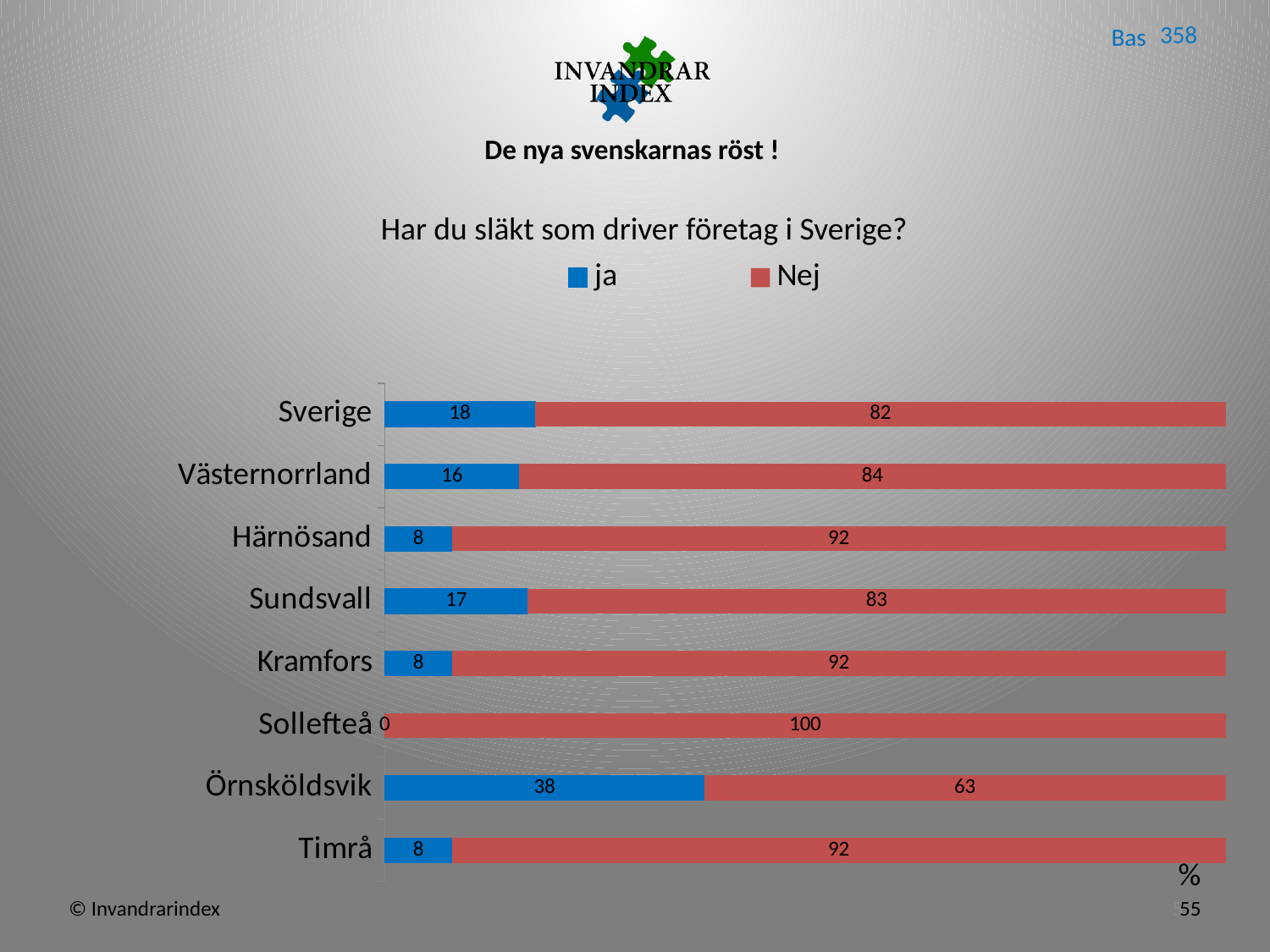
What is the 'Nej' value for Sollefteå? 100 What kind of chart is shown on the slide? Stacked bar chart What is the total of the stacked bar for Örnsköldsvik? 101 What is the 'ja' value for Örnsköldsvik? 38 Which category has the lowest 'ja' value? Sollefteå Which is larger, the 'ja' value for Sundsvall or the 'ja' value for Västernorrland? Sundsvall How many categories are shown on the chart? 8 How many series does the legend list? 2 Which category has the highest 'ja' value? Örnsköldsvik What is the 'ja' value for Sverige? 18 What is the 'Nej' value for Härnösand? 92 What is the difference between the 'Nej' values for Västernorrland and Sverige? 2